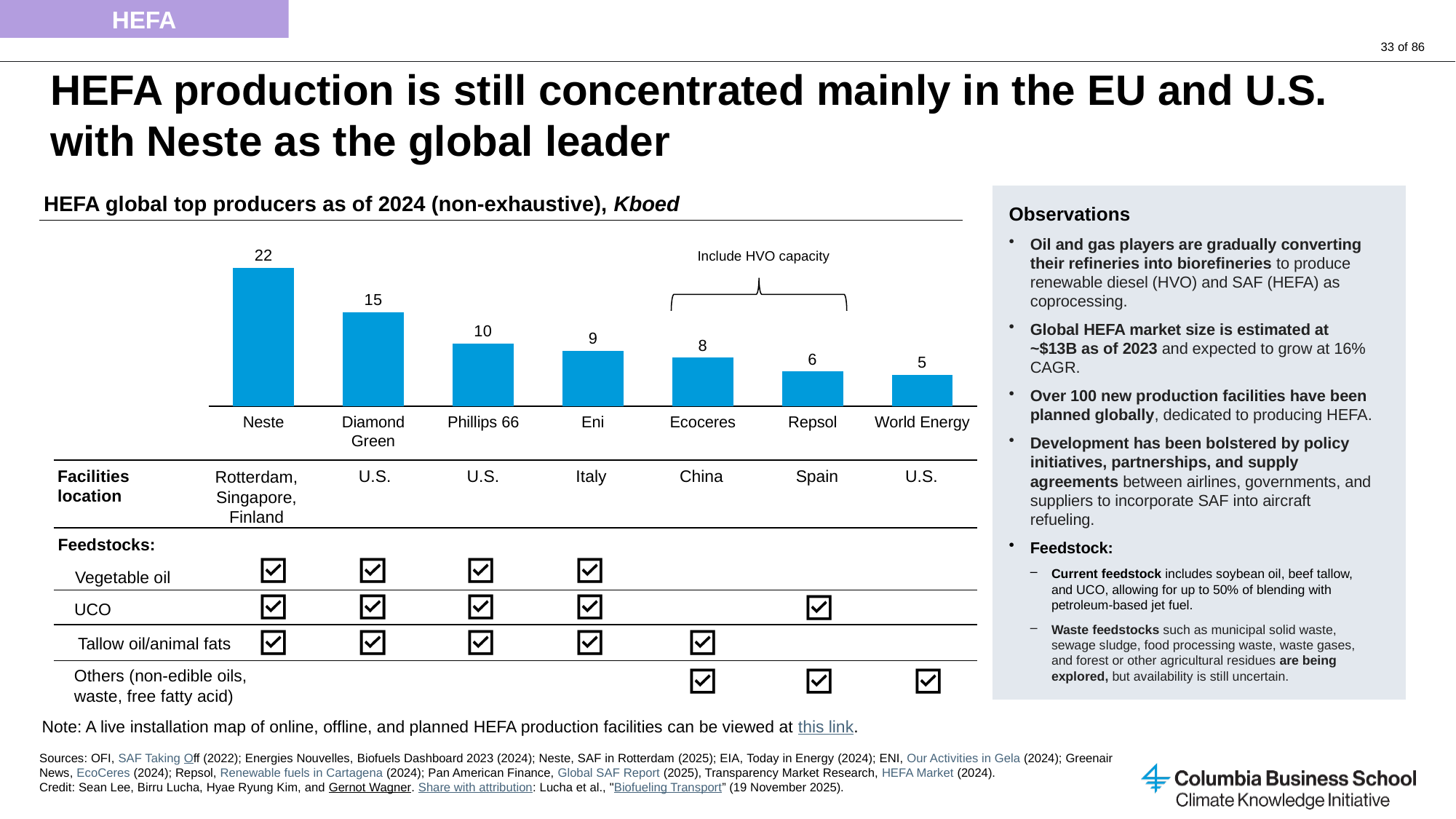
Which producer has the highest value in the chart? Neste What unit is given in the chart title for the values? Kboed What is the value for Ecoceres in the chart? 8 What is the value for Diamond Green in the chart? 15 What kind of chart is used to show the HEFA global top producers? Bar chart Which producer has the lowest value in the chart? World Energy Do the values rise or fall moving from left to right across the chart? Fall What is the difference between the values for Neste and Diamond Green? 7 How many producers are shown in the chart? 7 What is the value for Neste in the HEFA global top producers chart? 22 What is the difference between the values for Phillips 66 and Repsol? 4 Which has a larger value, Eni or Repsol? Eni